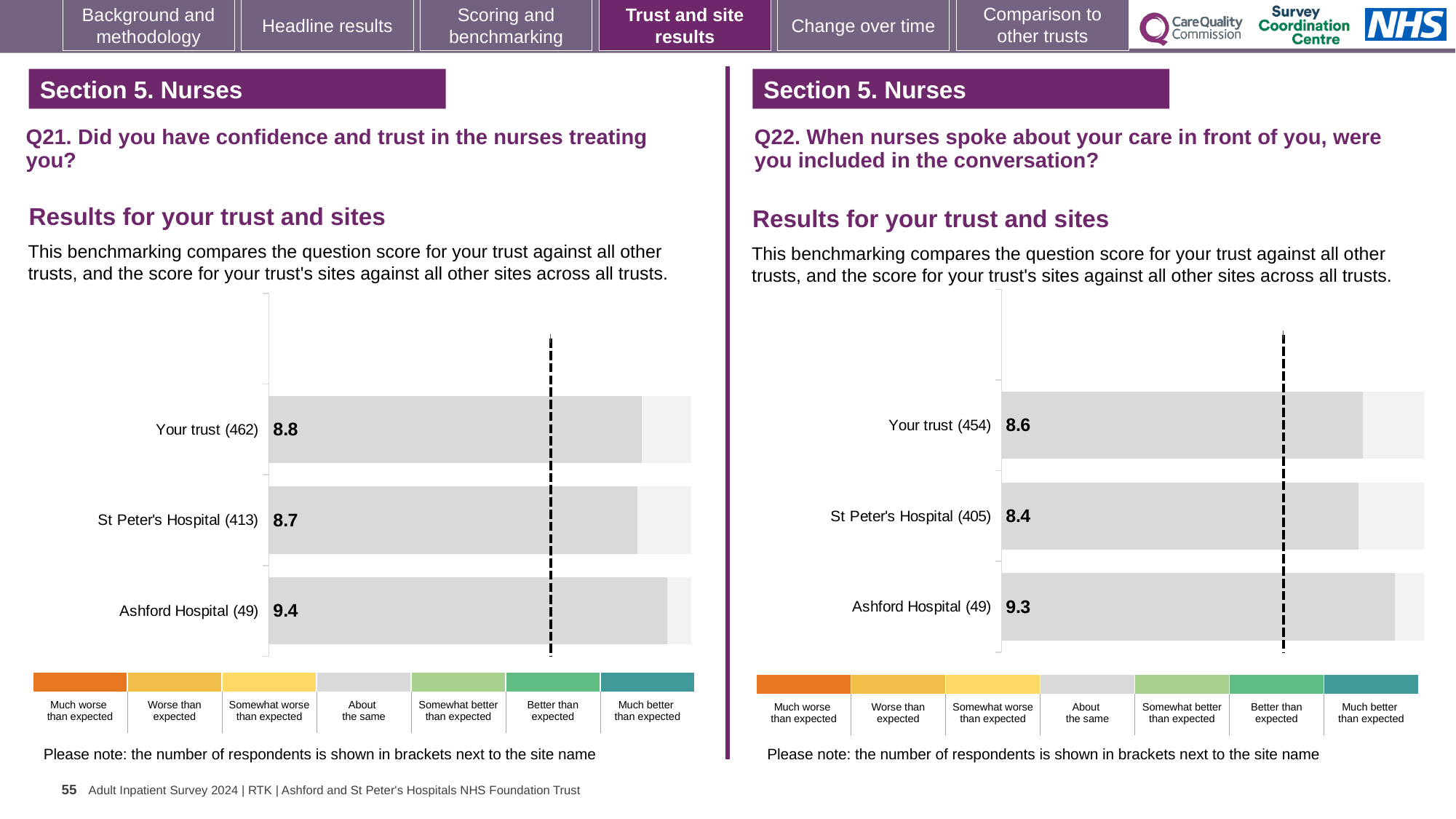
In the Q22 chart on the right, what is the difference between the scores for Ashford Hospital and Your trust? 0.7 In the Q22 chart on the right, what is the score for Your trust? 8.6 In the Q22 chart on the right, what is the score for St Peter's Hospital? 8.4 In the Q21 chart on the left, which site or trust has the lowest score? St Peter's Hospital In the Q22 chart on the right, which has the larger score, Your trust or St Peter's Hospital? Your trust In the Q21 chart on the left, what is the difference between the scores for Ashford Hospital and St Peter's Hospital? 0.7 How many bars are shown in the Q21 chart on the left? 3 In the Q21 chart on the left, which site or trust has the highest score? Ashford Hospital In the Q21 chart on the left, what is the score for Your trust? 8.8 What type of chart is used for the Q22 results on the right? Bar chart In the Q21 chart on the left, what is the score for Ashford Hospital? 9.4 In the Q22 chart on the right, which site or trust has the highest score? Ashford Hospital